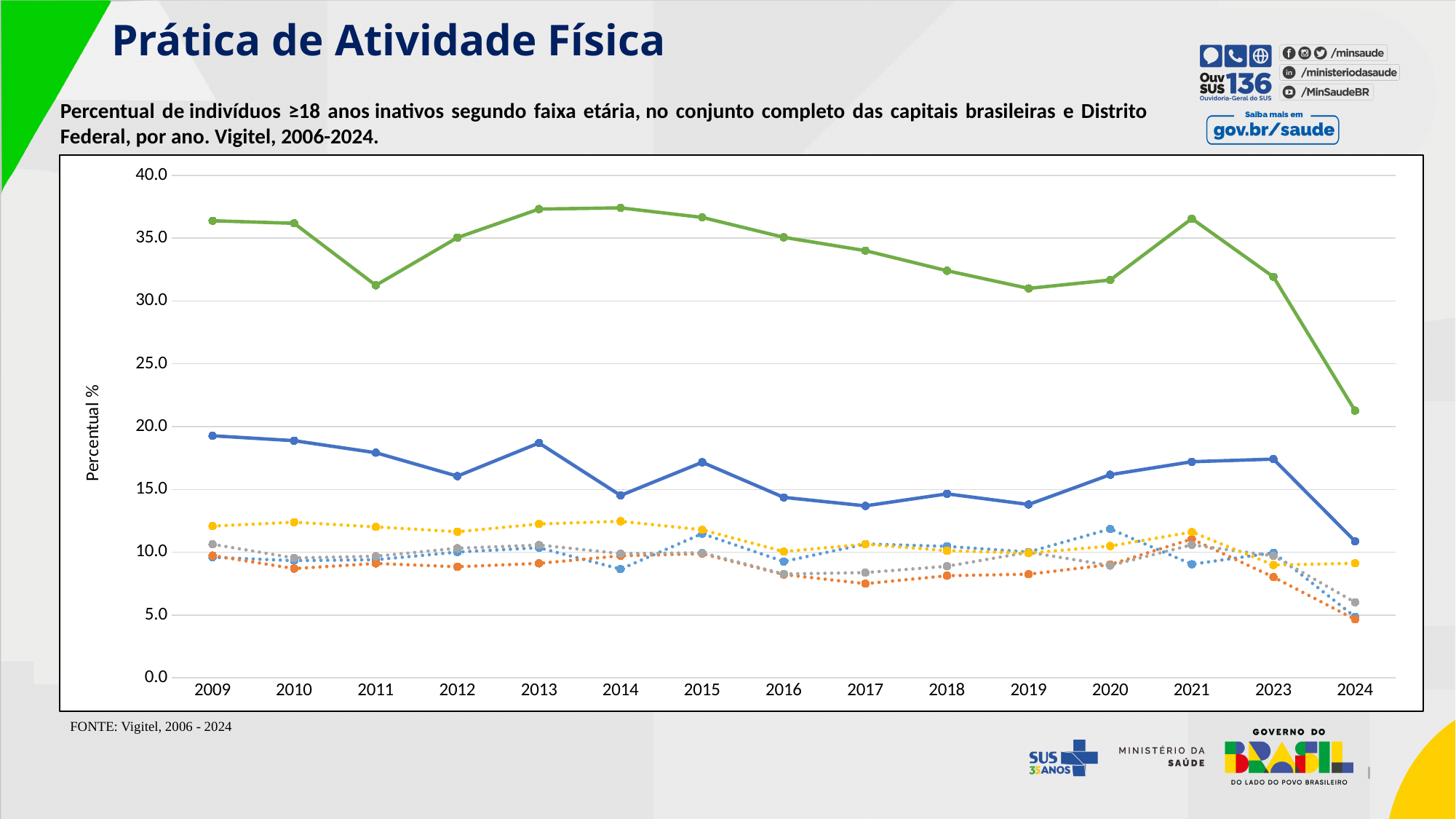
How many lines are plotted on the chart? 6 Does the green line rise or fall between 2021 and 2024? fall Is the value of the green line in 2009 greater or less than 35.0? greater Which is larger in 2024, the green line or the dark blue solid line? green line In which year does the green line reach its lowest value? 2024 How many years are shown on the x axis of the chart? 15 Is the value of the dark blue solid line in 2012 greater or less than 15.0? greater In which year does the dark blue solid line reach its lowest value? 2024 Is the value of the green line in 2024 greater or less than 25.0? less What is the label on the y axis of the chart? Percentual % What kind of chart is shown on the slide? line chart